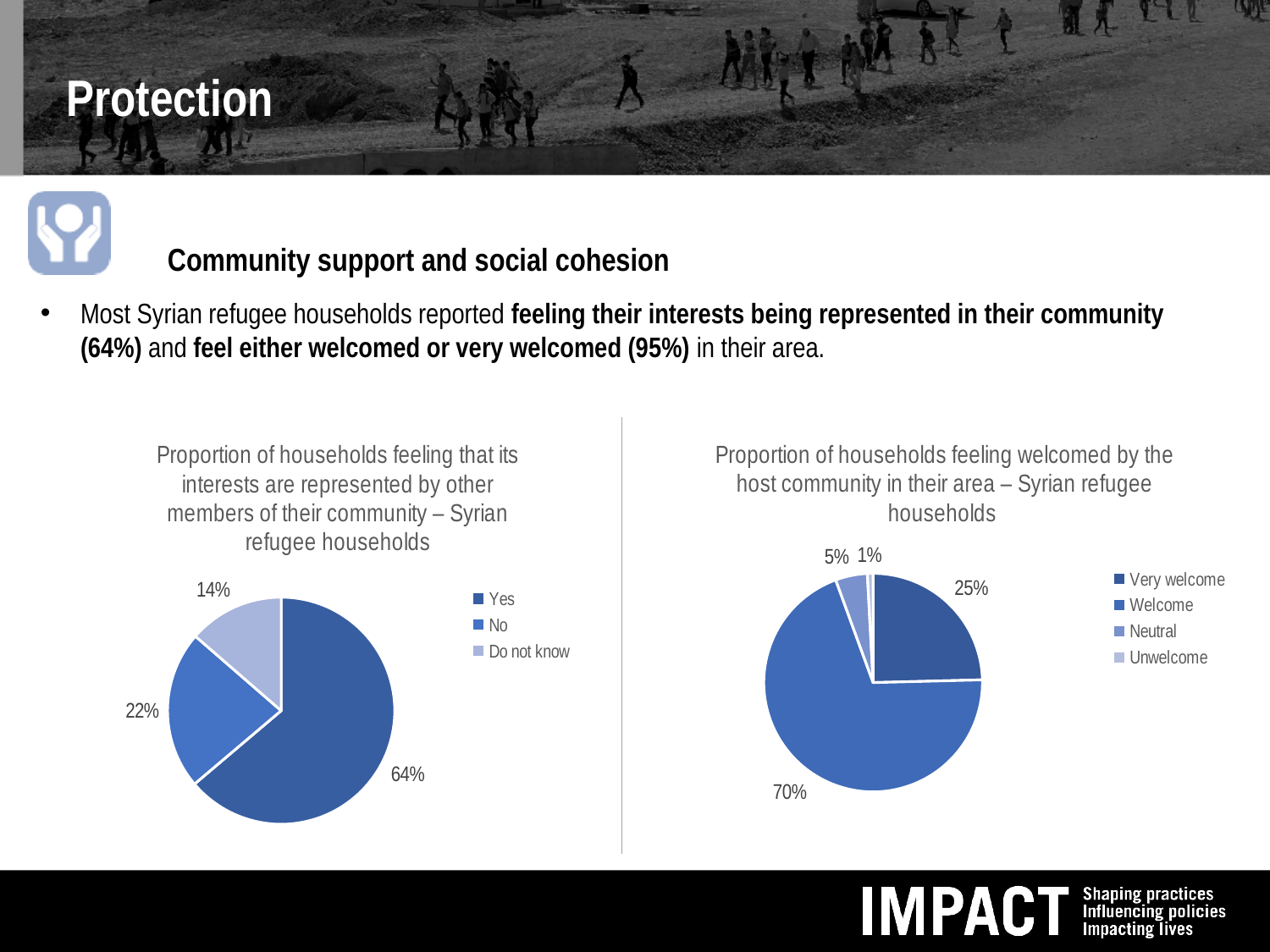
In the left pie chart on households feeling their interests are represented, what share of households answered No? 22% In the right pie chart on households feeling welcomed by the host community, which response has the largest share? Welcome What type of chart is the left chart on households feeling their interests are represented? Pie chart In the right pie chart on households feeling welcomed by the host community, what share of households feel Very welcome? 25% In the right pie chart on households feeling welcomed by the host community, which is larger: the Neutral share or the Unwelcome share? Neutral How many categories does the legend of the right pie chart on households feeling welcomed by the host community list? 4 In the left pie chart on households feeling their interests are represented, which response has the smallest share? Do not know In the left pie chart on households feeling their interests are represented, what share of households answered Yes? 64% In the left pie chart on households feeling their interests are represented, what is the difference between the Yes and No shares? 42% In the left pie chart on households feeling their interests are represented, what share of households answered Do not know? 14% In the right pie chart on households feeling welcomed by the host community, what share of households feel Unwelcome? 1% In the right pie chart on households feeling welcomed by the host community, what share of households feel Welcome? 70%